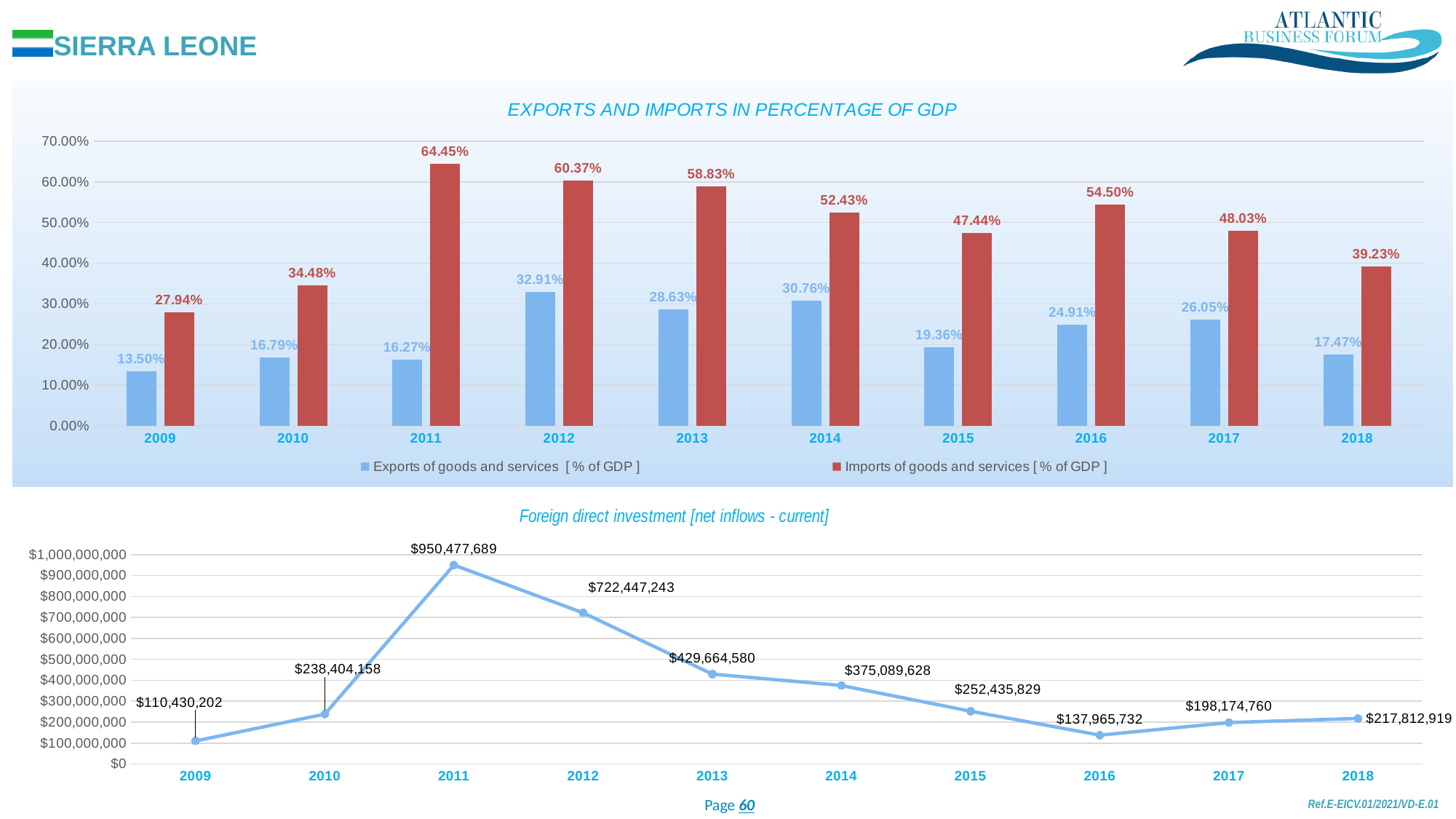
In the 'Foreign direct investment [net inflows - current]' chart, which is larger, the value for 2017 or the value for 2018? 2018 In the 'EXPORTS AND IMPORTS IN PERCENTAGE OF GDP' chart, how many series does the legend list? 2 In the 'EXPORTS AND IMPORTS IN PERCENTAGE OF GDP' chart, what is the value of Imports of goods and services in 2011? 64.45% In the 'EXPORTS AND IMPORTS IN PERCENTAGE OF GDP' chart, what is the value of Exports of goods and services in 2012? 32.91% In the 'Foreign direct investment [net inflows - current]' chart, how many years are plotted? 10 In the 'Foreign direct investment [net inflows - current]' chart, what is the value for 2011? $950,477,689 In the 'EXPORTS AND IMPORTS IN PERCENTAGE OF GDP' chart, which year has the lowest Exports of goods and services value? 2009 In the 'EXPORTS AND IMPORTS IN PERCENTAGE OF GDP' chart, what is the difference between Imports and Exports in 2018? 21.76% What kind of chart is the 'Foreign direct investment [net inflows - current]' chart? Line chart In the 'Foreign direct investment [net inflows - current]' chart, which year has the lowest value? 2009 What kind of chart is the 'EXPORTS AND IMPORTS IN PERCENTAGE OF GDP' chart? Bar chart In the 'EXPORTS AND IMPORTS IN PERCENTAGE OF GDP' chart, which year has the highest Imports of goods and services value? 2011